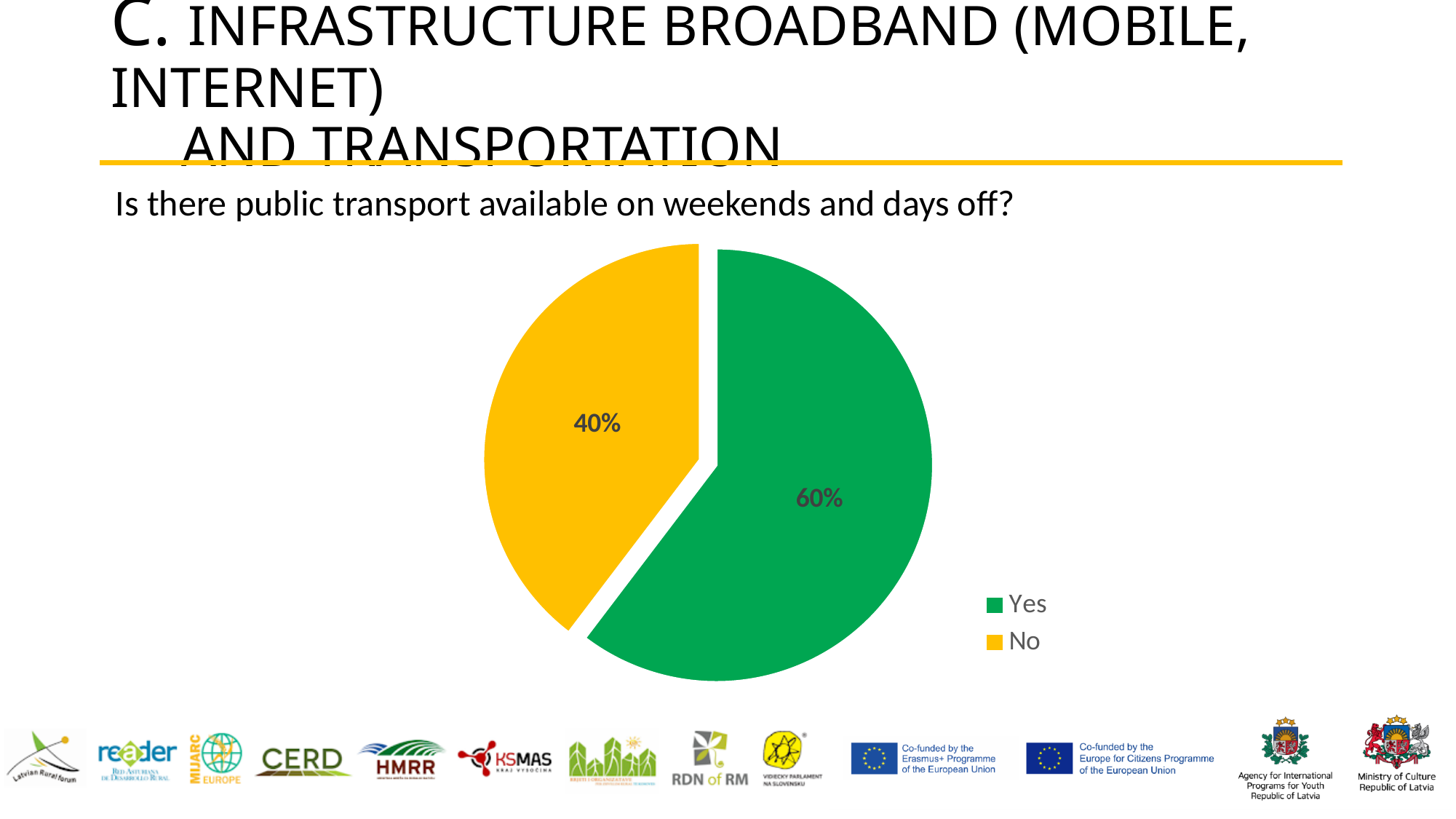
Which category has the largest slice of the pie? Yes How many slices does the pie chart have? 2 Which is larger, the "Yes" slice or the "No" slice? Yes What colour is the "No" slice in the pie chart? yellow What kind of chart is shown on the slide? pie chart Which category has the smallest slice of the pie? No What question does the pie chart answer, according to the text above it? Is there public transport available on weekends and days off? What share of the pie does the "No" slice represent? 40% How many entries does the legend list? 2 What is the difference in percentage points between the "Yes" and "No" slices? 20% What share of the pie does the "Yes" slice represent? 60%